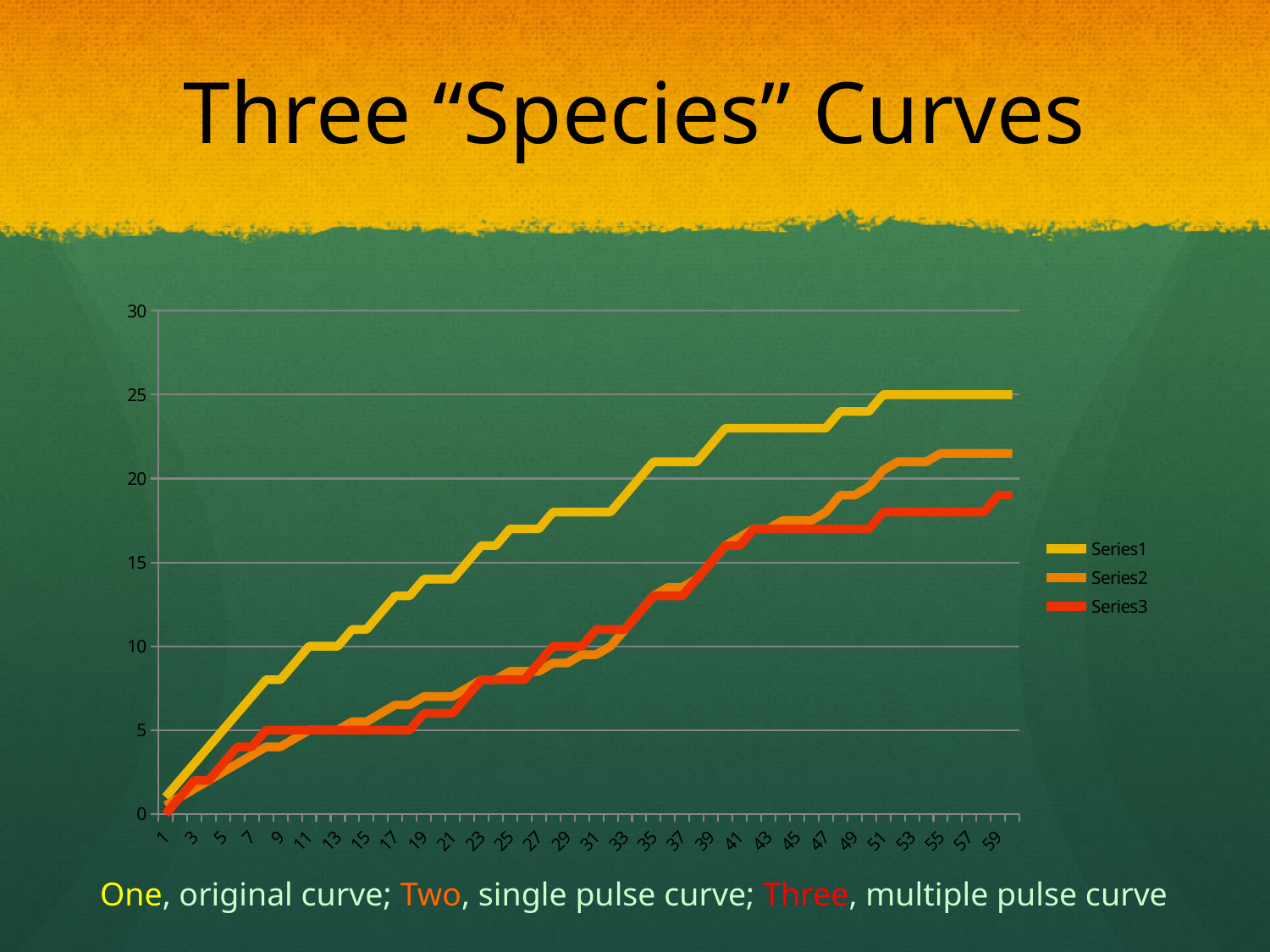
How many series does the legend list? 3 Which series has the highest value at x = 59? Series1 At x = 21, which is larger, Series1 or Series3? Series1 What is the value of Series1 at x = 59? 25 What are the names of the series in the legend? Series1, Series2, Series3 Do the values of Series1 rise or fall along the x axis? rise Is the value for Series1 at x = 31 greater or less than 15? greater Is the value for Series3 at x = 59 greater or less than 20? less What kind of chart is shown on the slide? line chart What is the title of the slide containing the chart? Three "Species" Curves Which series has the lowest value at x = 59? Series3 Is the value for Series2 at x = 59 greater or less than 20? greater